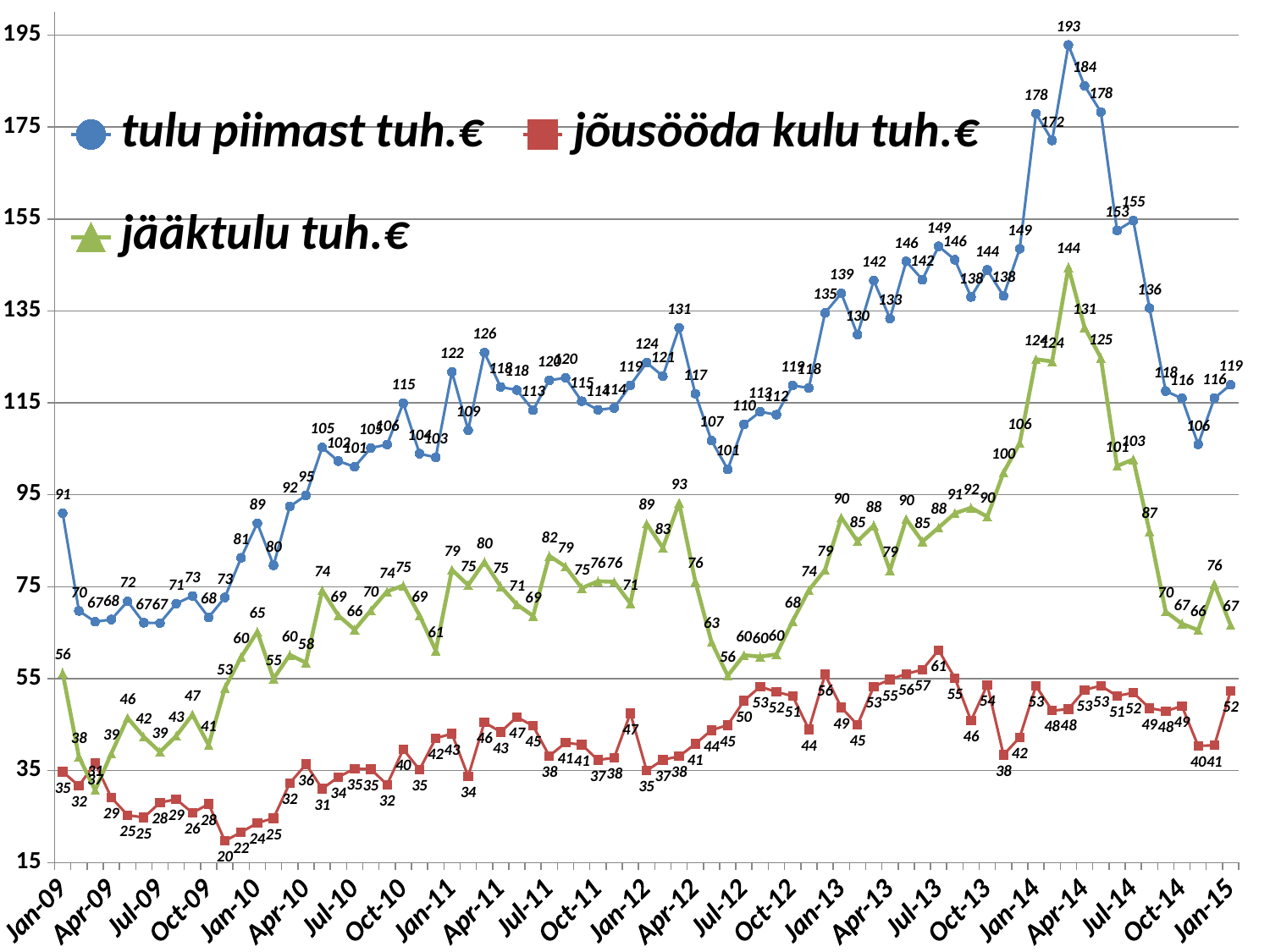
Which series is drawn with green triangle markers? jääktulu tuh.€ What is the lowest value of the 'jõusööda kulu tuh.€' series? 20 What is the highest value reached by the 'tulu piimast tuh.€' series? 193 Is the value of 'tulu piimast tuh.€' larger at Jan-09 or at Jan-15? Jan-15 What is the value of 'jõusööda kulu tuh.€' at Jan-15? 52 What is the value of 'jääktulu tuh.€' at Jan-15? 67 What is the highest value reached by the 'jääktulu tuh.€' series? 144 How many series does the legend list? 3 At Jan-15, what is the difference between 'tulu piimast tuh.€' and 'jõusööda kulu tuh.€'? 67 What is the value of 'tulu piimast tuh.€' at Jan-09? 91 What is the highest value of the 'jõusööda kulu tuh.€' series? 61 What kind of chart is shown on the slide? line chart